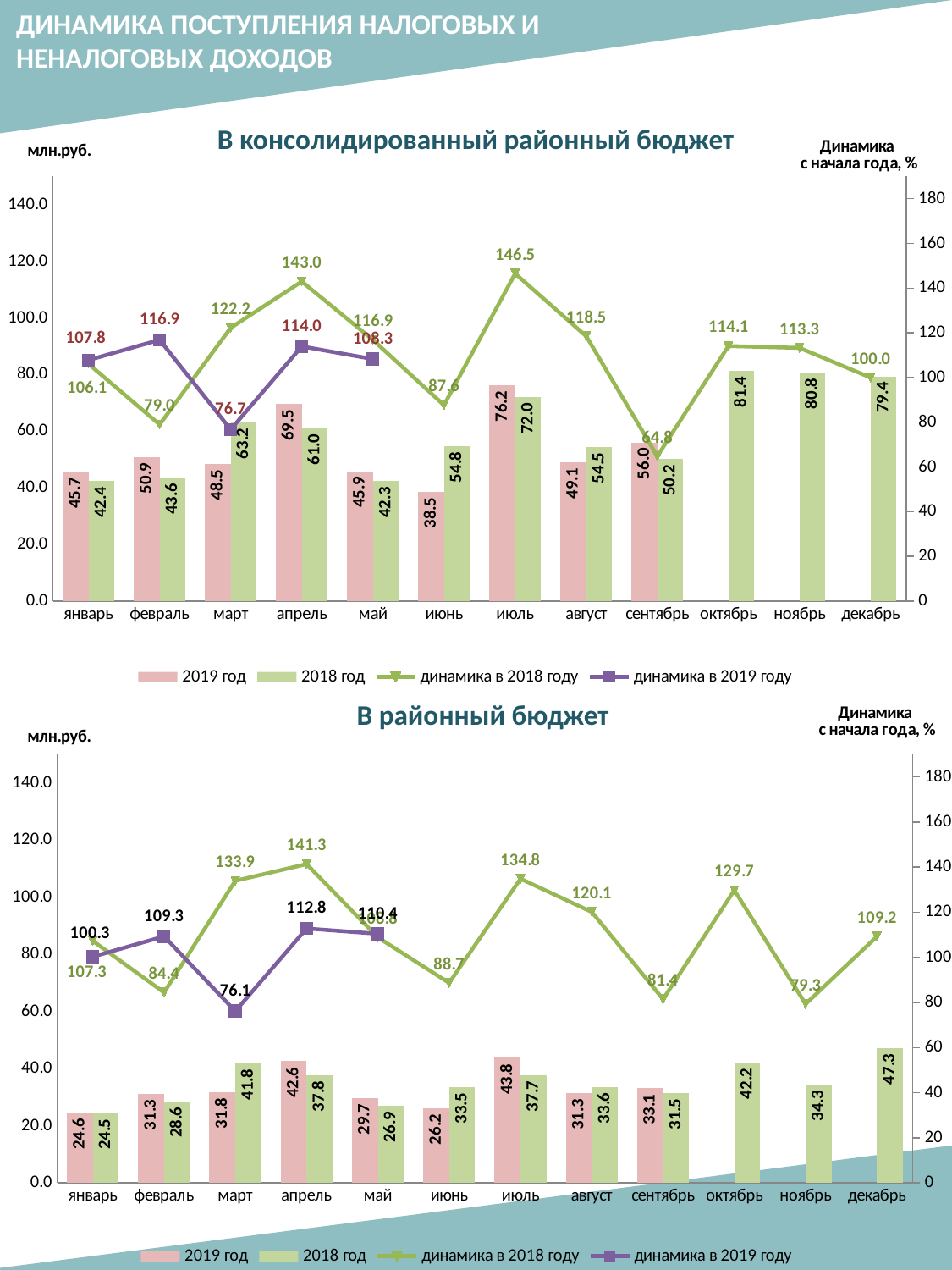
In the chart 'В консолидированный районный бюджет', what is the value of the 2018 год bar for октябрь? 81.4 In the chart 'В консолидированный районный бюджет', which is larger for март: the 2019 год bar or the 2018 год bar? 2018 год In the chart 'В консолидированный районный бюджет', which month has the lowest value of 'динамика в 2018 году'? сентябрь In the chart 'В консолидированный районный бюджет', what is the difference between the 2019 год and 2018 год bars for июль? 4.2 In the chart 'В консолидированный районный бюджет', what is the value of the 2019 год bar for июль? 76.2 In the chart 'В районный бюджет', what is the difference between the 2019 год and 2018 год bars for апрель? 4.8 How many series does the legend of the chart 'В консолидированный районный бюджет' list? 4 In the chart 'В районный бюджет', what is the value of 'динамика в 2019 году' for март? 76.1 How many months are shown on the x axis of the chart 'В районный бюджет'? 12 In the chart 'В районный бюджет', which month has the lowest value of the 2019 год bars? январь In the chart 'В районный бюджет', what is the value of the 2018 год bar for декабрь? 47.3 In the chart 'В консолидированный районный бюджет', which month has the highest value of 'динамика в 2018 году'? июль